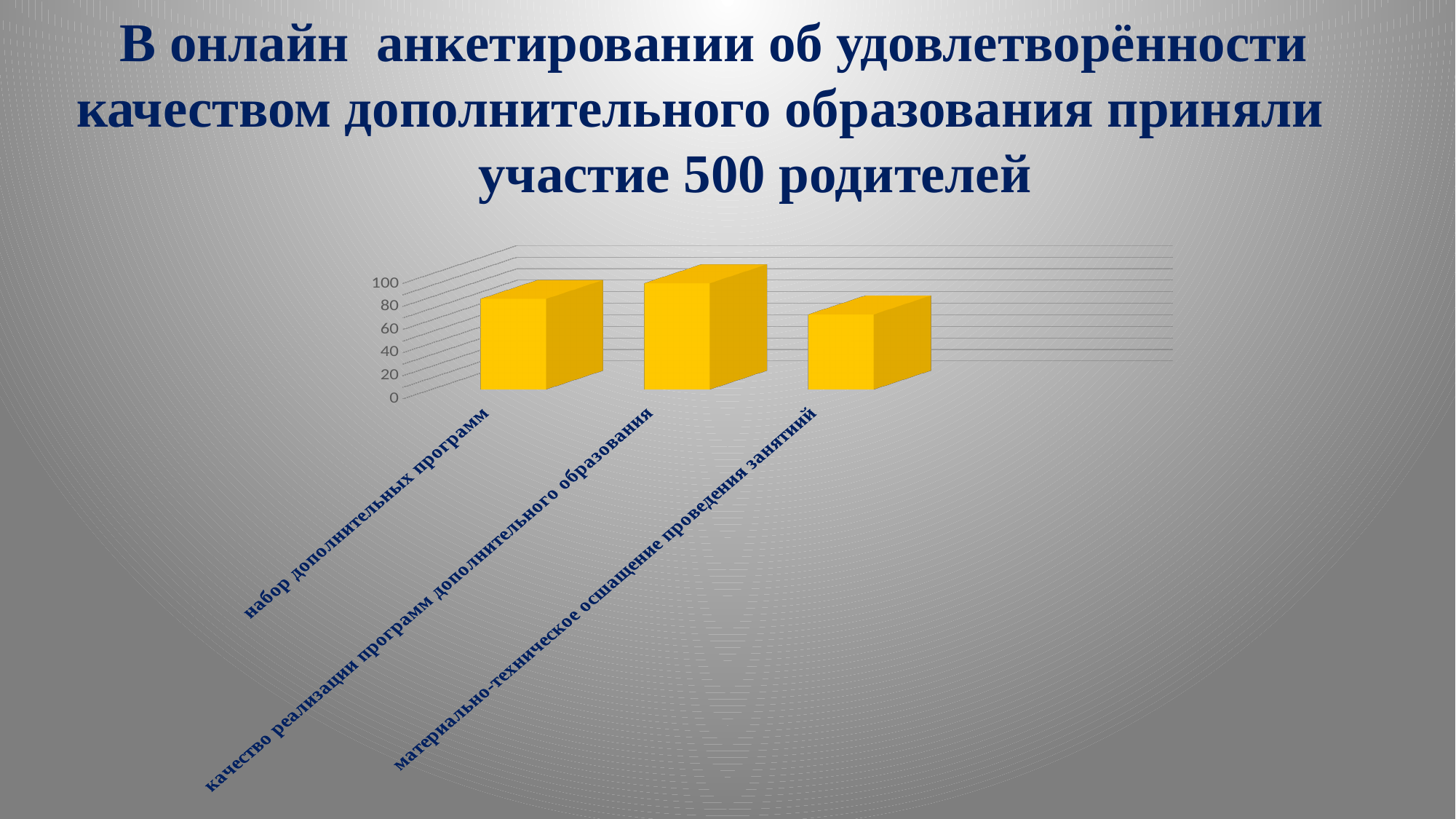
What kind of chart is shown on the slide? bar chart What colour are the bars in the chart? yellow How many categories are plotted in the chart? 3 Which category has the lowest bar in the chart? материально-техническое осшащение проведения занятиий Which is larger: the value for 'набор дополнительных программ' or for 'материально-техническое оснащение проведения занятий'? набор дополнительных программ Is the value for 'материально-техническое оснащение проведения занятий' greater or less than 40? greater Is the value for 'качество реализации программ дополнительного образования' greater or less than 80? greater How many parents took part in the survey according to the slide title? 500 Which category has the highest bar in the chart? качество реализации программ дополнительного образования Which is larger: the value for 'качество реализации программ дополнительного образования' or for 'набор дополнительных программ'? качество реализации программ дополнительного образования Is the value for 'материально-техническое оснащение проведения занятий' greater or less than 100? less What is the highest tick value shown on the vertical axis of the chart? 100